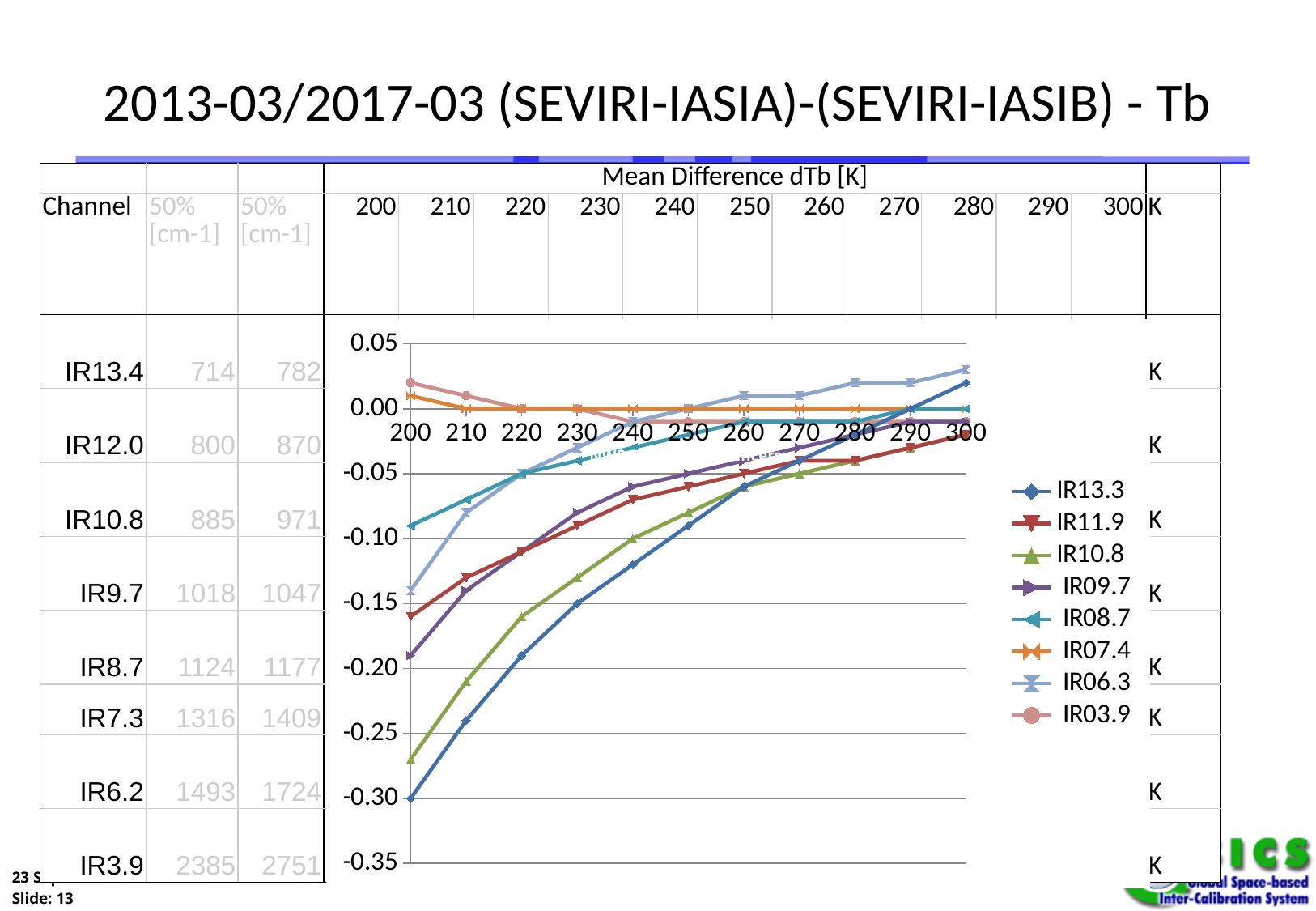
How many x-axis points (from 200 to 300) does each series in the chart span? 11 What is the lowest tick value shown on the chart's y-axis? -0.35 Is the value of IR08.7 at x = 200 greater or less than -0.05? less Is the value of IR09.7 at x = 200 greater or less than -0.15? less How many series does the chart legend list? 8 What kind of chart is shown on the slide? line chart Which series has the lowest value at x = 200 in the chart? IR13.3 Is the value of IR11.9 at x = 200 greater or less than -0.10? less Does the IR13.3 series rise or fall as x increases from 200 to 300? rise At x = 200, which series has the larger value, IR10.8 or IR09.7? IR09.7